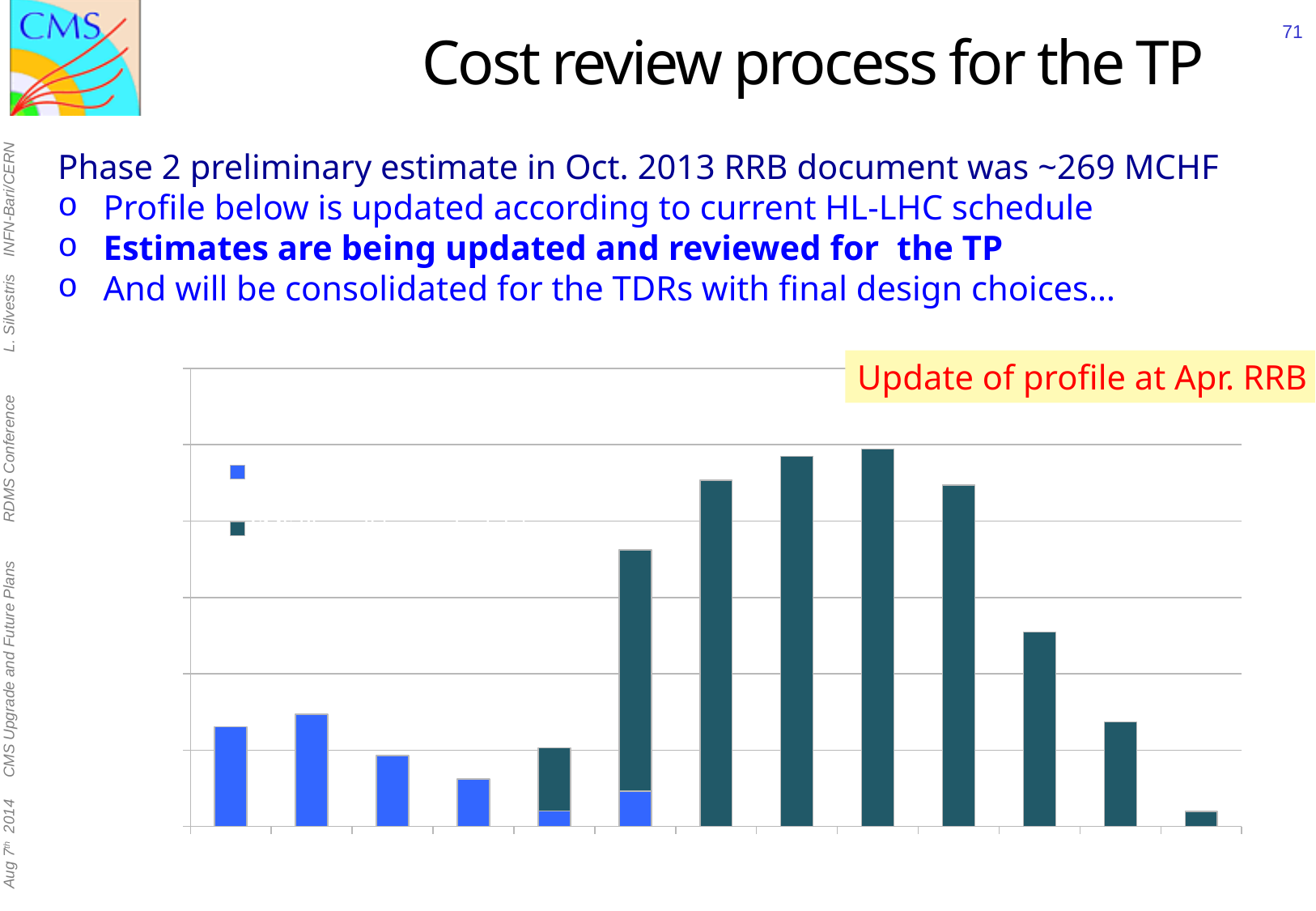
What does the yellow box above the chart say? Update of profile at Apr. RRB Counting from the left, which bar in the chart is the tallest? the 9th bar How many bars are plotted in the chart? 13 How many bars in the chart contain both the blue and the dark teal series? 2 Is the 7th bar from the left taller or shorter than the 2nd bar? taller Is the first bar from the left taller or shorter than the last bar on the right? taller How many series does the chart's legend list? 2 Counting from the left, which bar in the chart is the shortest? the 13th (last) bar What two colours are used for the series in the chart? blue and dark teal How many bars in the chart are made up entirely of the blue series? 4 What kind of chart is shown on the slide? bar chart